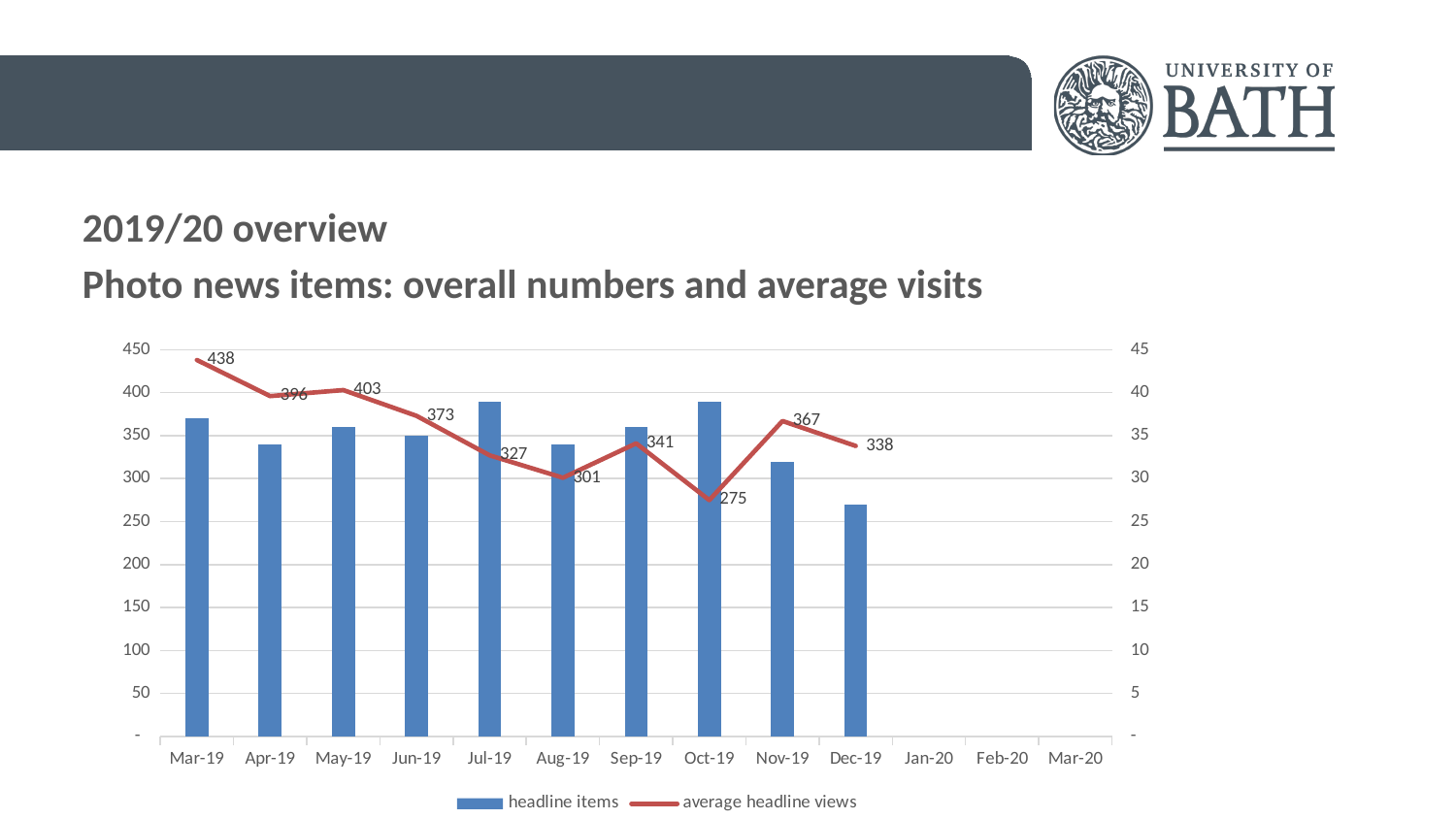
What is the average headline views value for Oct-19? 275 What kind of chart is shown on the slide? Combined bar and line chart Which month has higher average headline views, Apr-19 or May-19? May-19 What is the average headline views value for Mar-19? 438 How many series does the legend list? 2 Does the average headline views line rise or fall from Mar-19 to Aug-19? Fall Which month has the highest average headline views? Mar-19 How many months are labelled on the x axis? 13 What is the average headline views value for Dec-19? 338 What is the difference between the average headline views for Mar-19 and Oct-19? 163 Which month has the lowest average headline views? Oct-19 Is the headline items bar for Dec-19 greater or less than 300 on the left axis? less